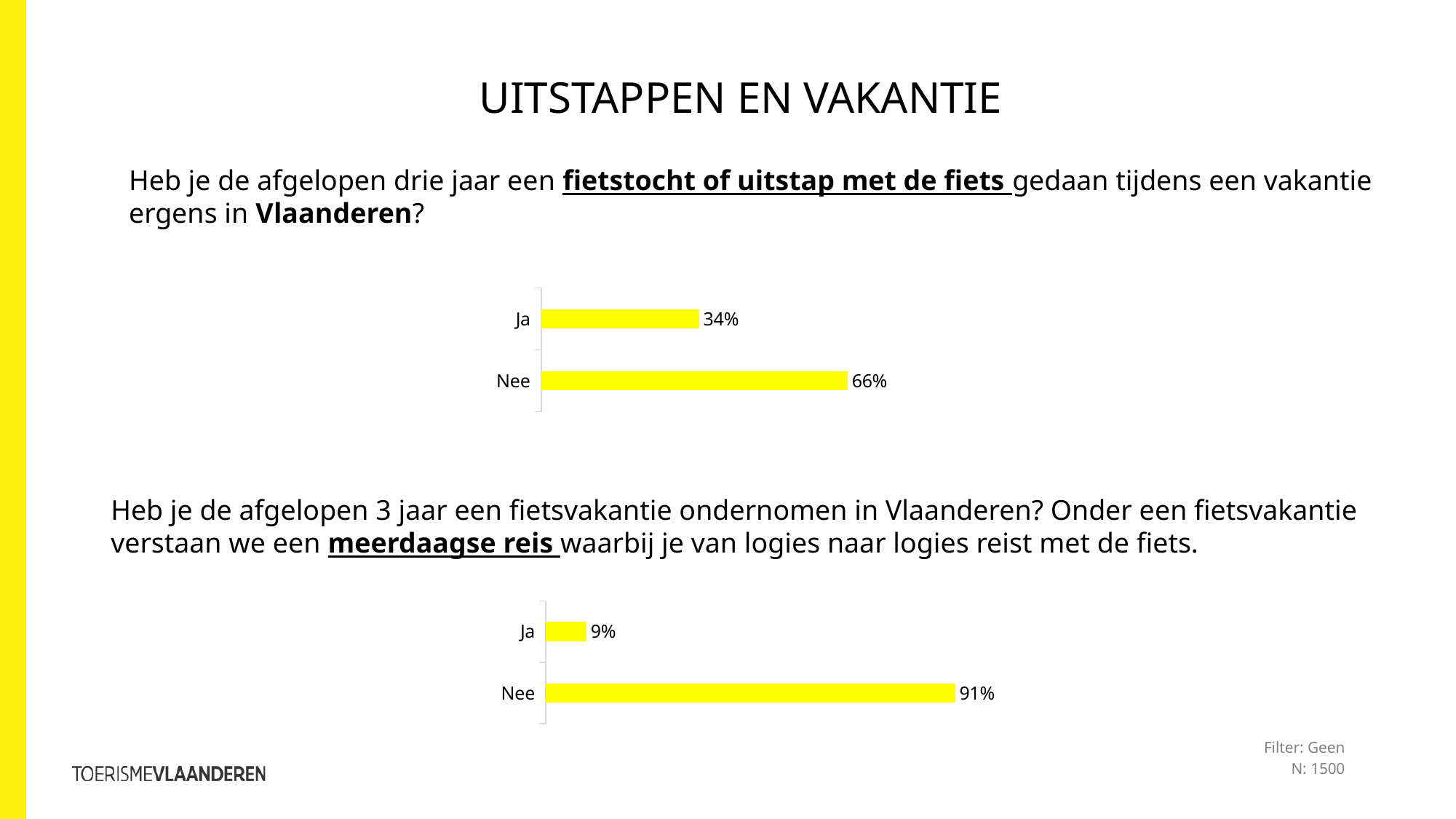
What type of chart is the bottom chart (fietsvakantie)? Bar chart In the top chart (fietstocht of uitstap met de fiets), what is the difference between Nee and Ja? 32% In the bottom chart (fietsvakantie), which category has the lowest value? Ja In the bottom chart (fietsvakantie), what is the difference between Nee and Ja? 82% What colour are the bars in both charts? Yellow In the top chart (fietstocht of uitstap met de fiets), what is the value for Nee? 66% Is the value for Ja larger in the top chart or in the bottom chart? Top chart In the bottom chart (fietsvakantie), what is the value for Nee? 91% How many categories does the top chart (fietstocht of uitstap met de fiets) show? 2 In the top chart (fietstocht of uitstap met de fiets), what is the value for Ja? 34% In the top chart (fietstocht of uitstap met de fiets), which category has the highest value? Nee In the bottom chart (fietsvakantie), what is the value for Ja? 9%